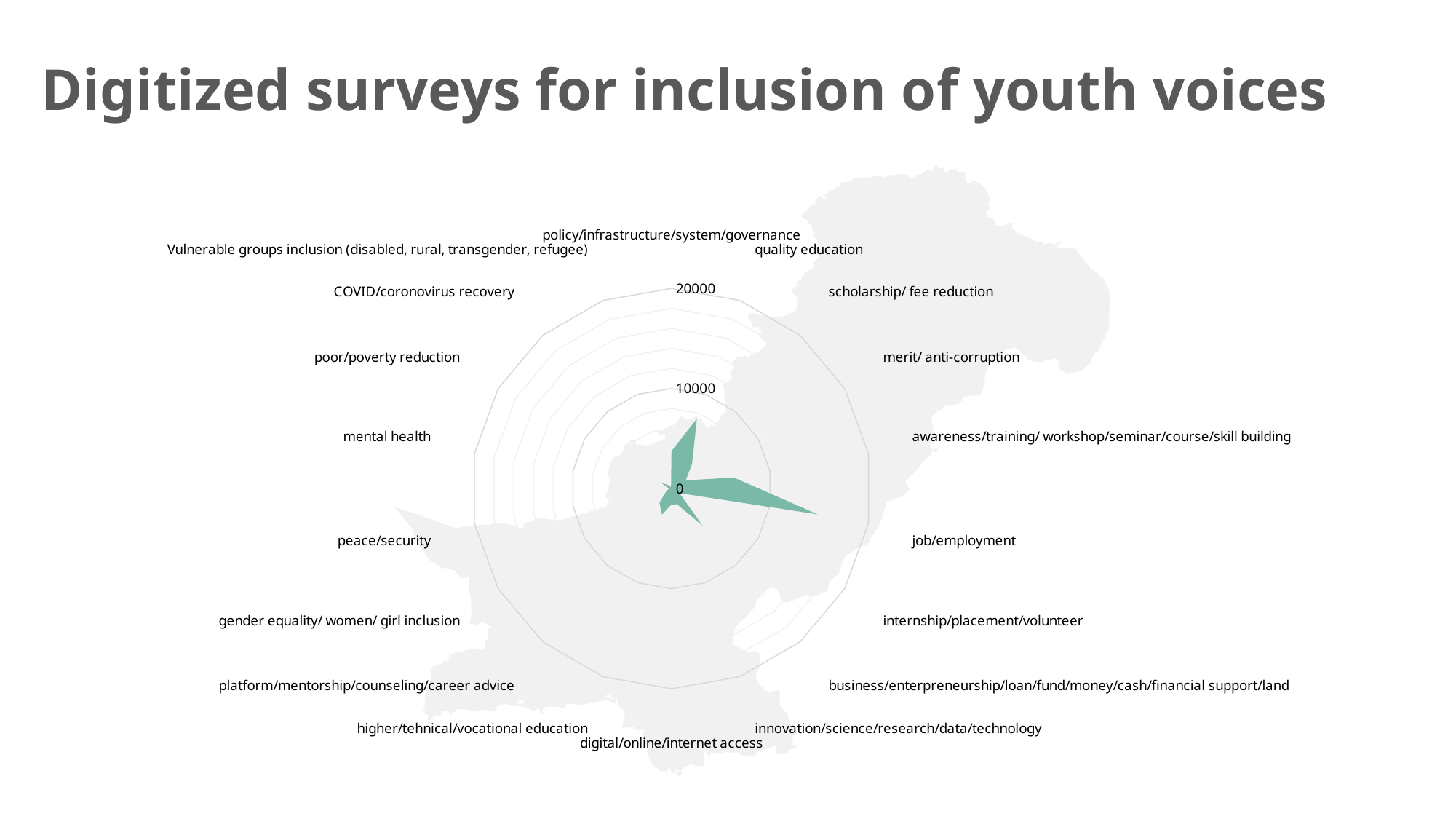
Which category has the highest value on the radar chart? job/employment Which is larger, the value for job/employment or the value for mental health? job/employment Which is larger, the value for job/employment or the value for COVID/coronovirus recovery? job/employment What is the highest tick value shown on the radial axis of the chart? 20000 What kind of chart is shown on the slide? radar chart Is the value for job/employment greater or less than 20000? less Is the value for job/employment greater or less than 10000? greater What is the title of the slide containing the radar chart? Digitized surveys for inclusion of youth voices Is the value for mental health greater or less than 10000? less How many categories are plotted on the radar chart? 18